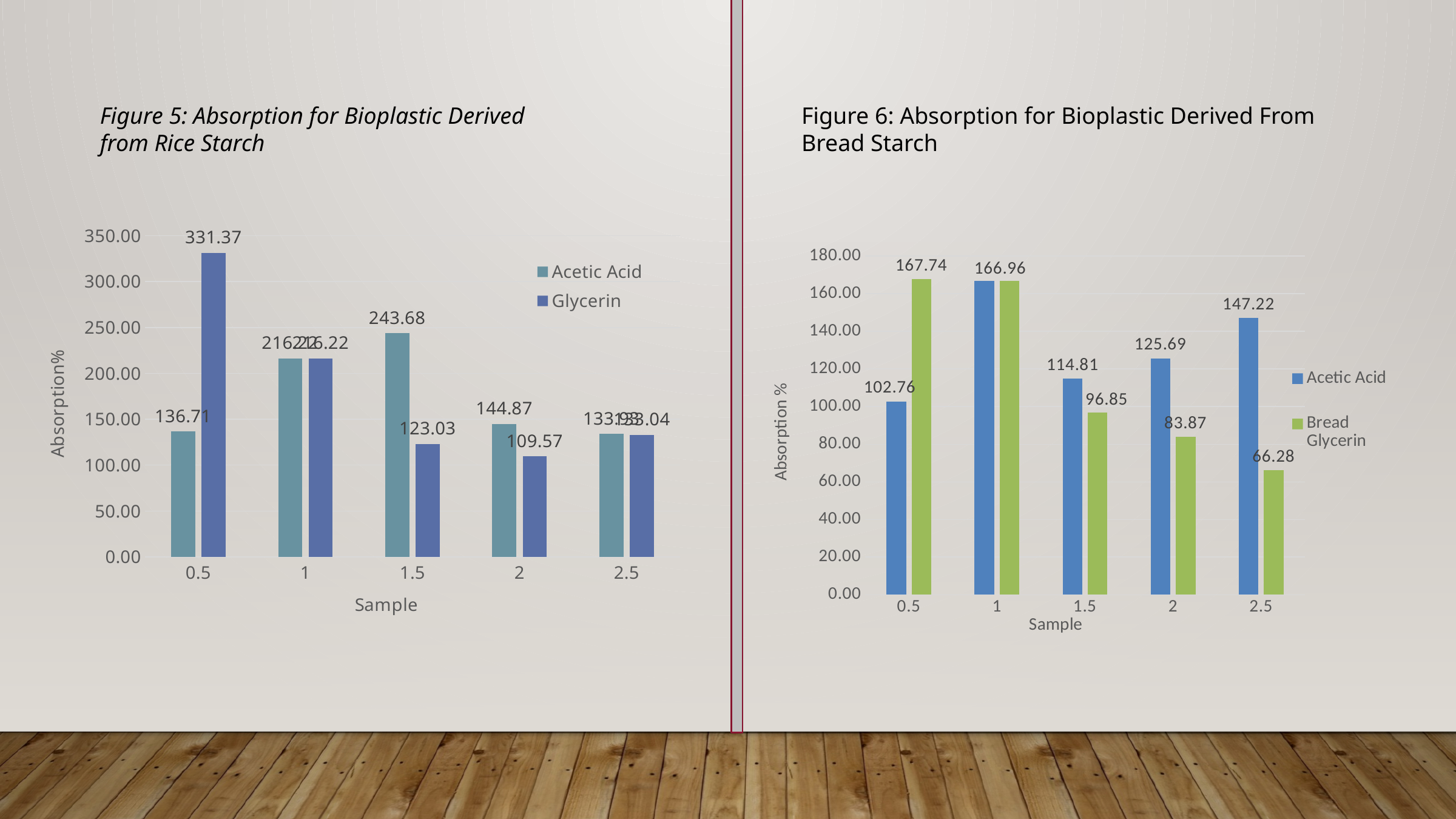
What kind of chart is Figure 6 (Bread Starch)? Bar chart In Figure 5 (Rice Starch), what is the Acetic Acid absorption value for sample 1.5? 243.68 In Figure 6 (Bread Starch), what is the Acetic Acid absorption value for sample 2? 125.69 In Figure 5 (Rice Starch), which sample has the highest Glycerin absorption? 0.5 In Figure 5 (Rice Starch), what is the difference between the Acetic Acid and Glycerin values for sample 2? 35.30 In Figure 6 (Bread Starch), what is the difference between the Bread Glycerin and Acetic Acid values for sample 0.5? 64.98 In Figure 6 (Bread Starch), what is the Bread Glycerin absorption value for sample 2.5? 66.28 In Figure 5 (Rice Starch), what is the Glycerin absorption value for sample 0.5? 331.37 In Figure 6 (Bread Starch), which sample has the lowest Bread Glycerin absorption? 2.5 In Figure 6 (Bread Starch), how many sample categories are shown on the x axis? 5 In Figure 5 (Rice Starch), how many series does the legend list? 2 In Figure 5 (Rice Starch), which is larger for sample 1.5: Acetic Acid or Glycerin? Acetic Acid